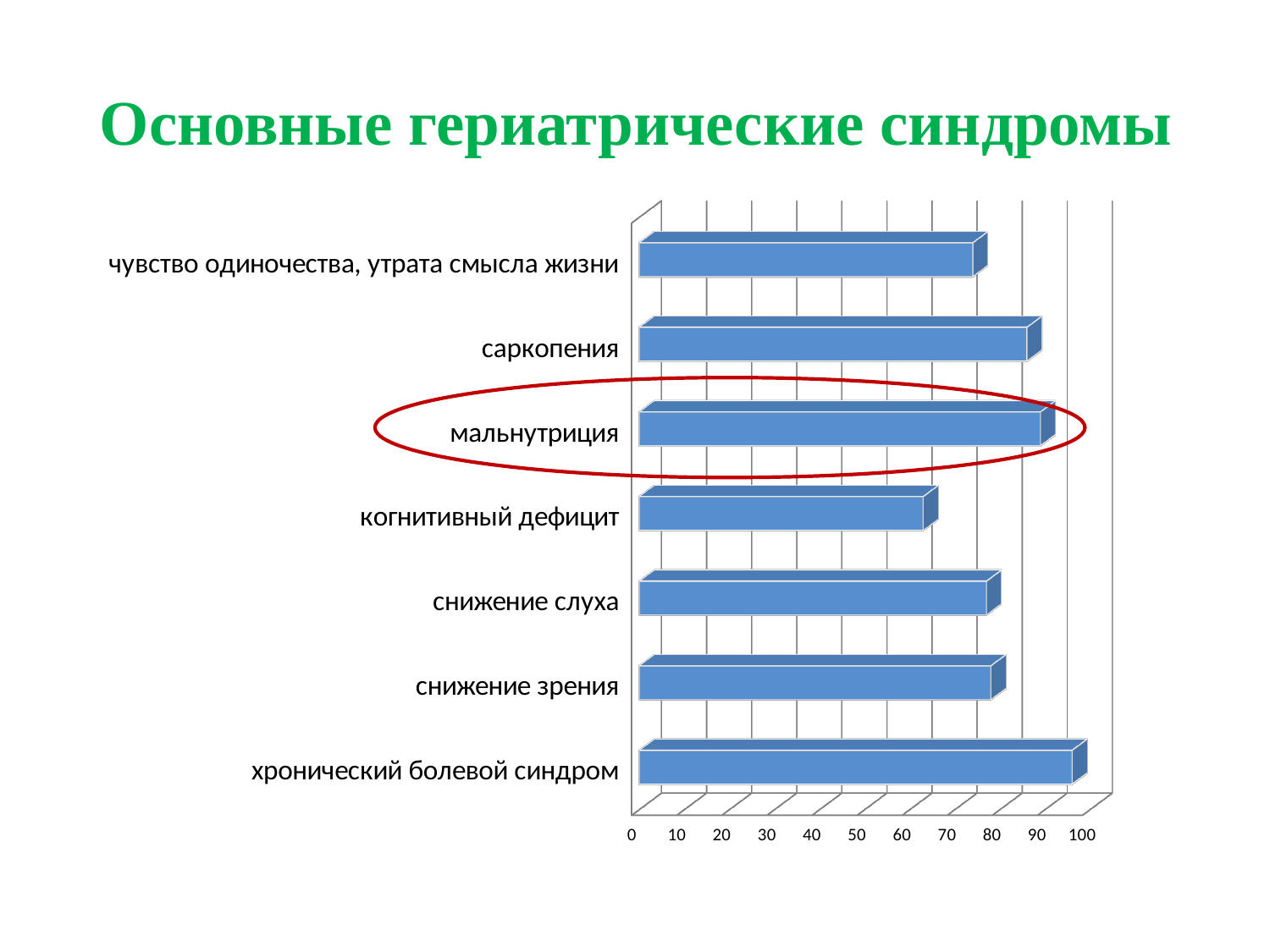
What kind of chart is shown on the slide? bar chart Is the value for хронический болевой синдром greater or less than 90? greater Is the value for когнитивный дефицит greater or less than 60? greater Which category has the lowest value in the chart? когнитивный дефицит Which is larger, the value for саркопения or the value for когнитивный дефицит? саркопения Is the value for чувство одиночества, утрата смысла жизни greater or less than 80? less How many categories are plotted in the chart? 7 Which category on the chart is circled in red? мальнутриция What is the title of the slide containing the chart? Основные гериатрические синдромы Which category has the highest value in the chart? хронический болевой синдром Which is larger, the value for хронический болевой синдром or the value for чувство одиночества, утрата смысла жизни? хронический болевой синдром